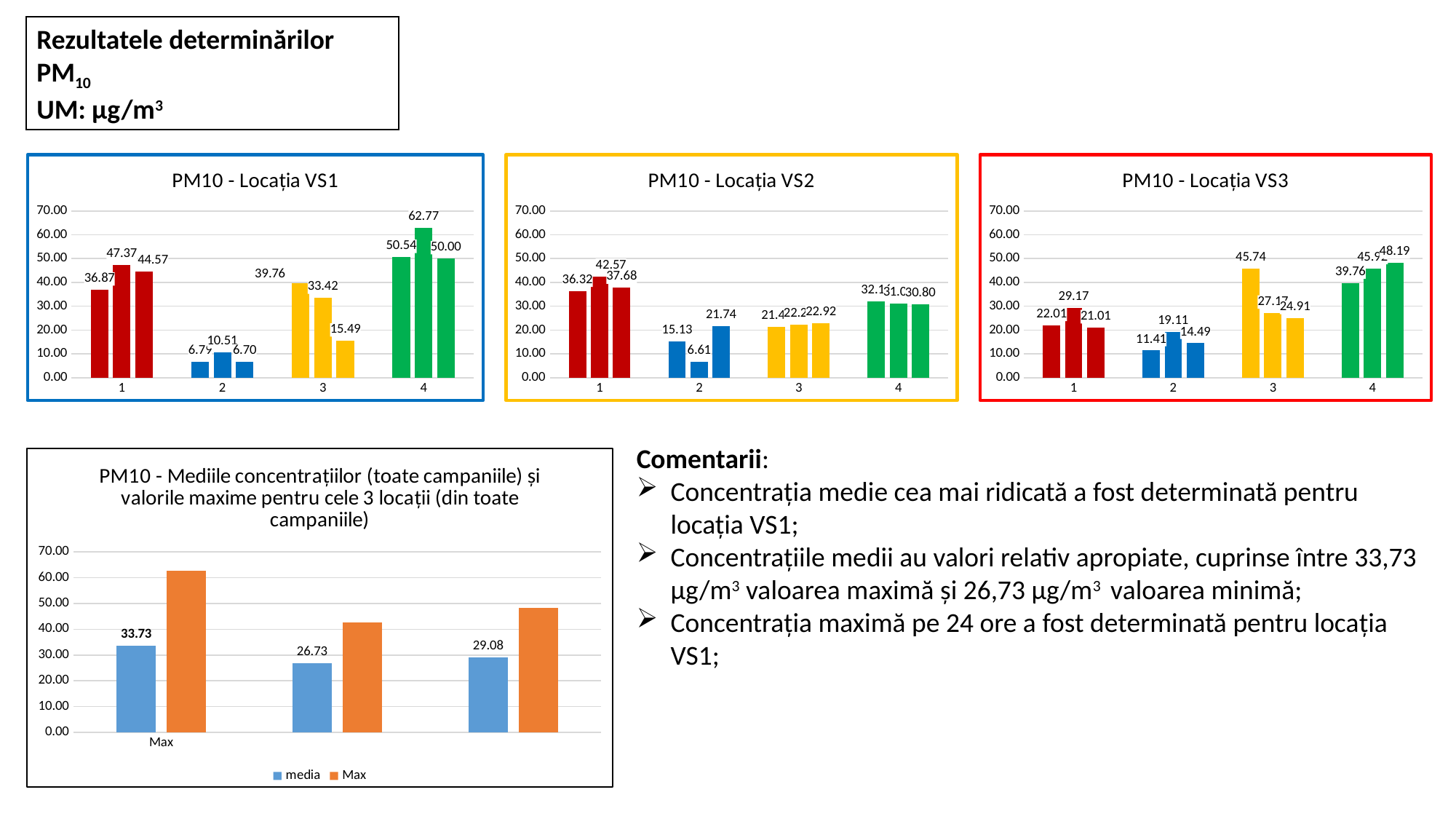
What kind of chart is 'PM10 - Locația VS2'? bar chart In the bottom-left chart 'PM10 - Mediile concentrațiilor...', is the first 'Max' bar greater or less than 60.00? greater In the chart 'PM10 - Locația VS3', what is the highest value shown? 48.19 In the chart 'PM10 - Locația VS2', what is the highest value shown? 42.57 In the chart 'PM10 - Locația VS1', what is the lowest value shown? 6.70 In the chart 'PM10 - Locația VS2', what is the lowest value shown? 6.61 In the chart 'PM10 - Locația VS3', which is larger: the first bar of group 3 (45.74) or the first bar of group 4 (39.76)? 45.74 In the chart 'PM10 - Locația VS3', what is the lowest value shown? 11.41 In the bottom-left chart 'PM10 - Mediile concentrațiilor...', what is the highest 'media' value? 33.73 In the bottom-left chart 'PM10 - Mediile concentrațiilor...', how many series does the legend list? 2 In the chart 'PM10 - Locația VS1', what is the difference between the highest value in group 4 (62.77) and the highest value in group 1 (47.37)? 15.40